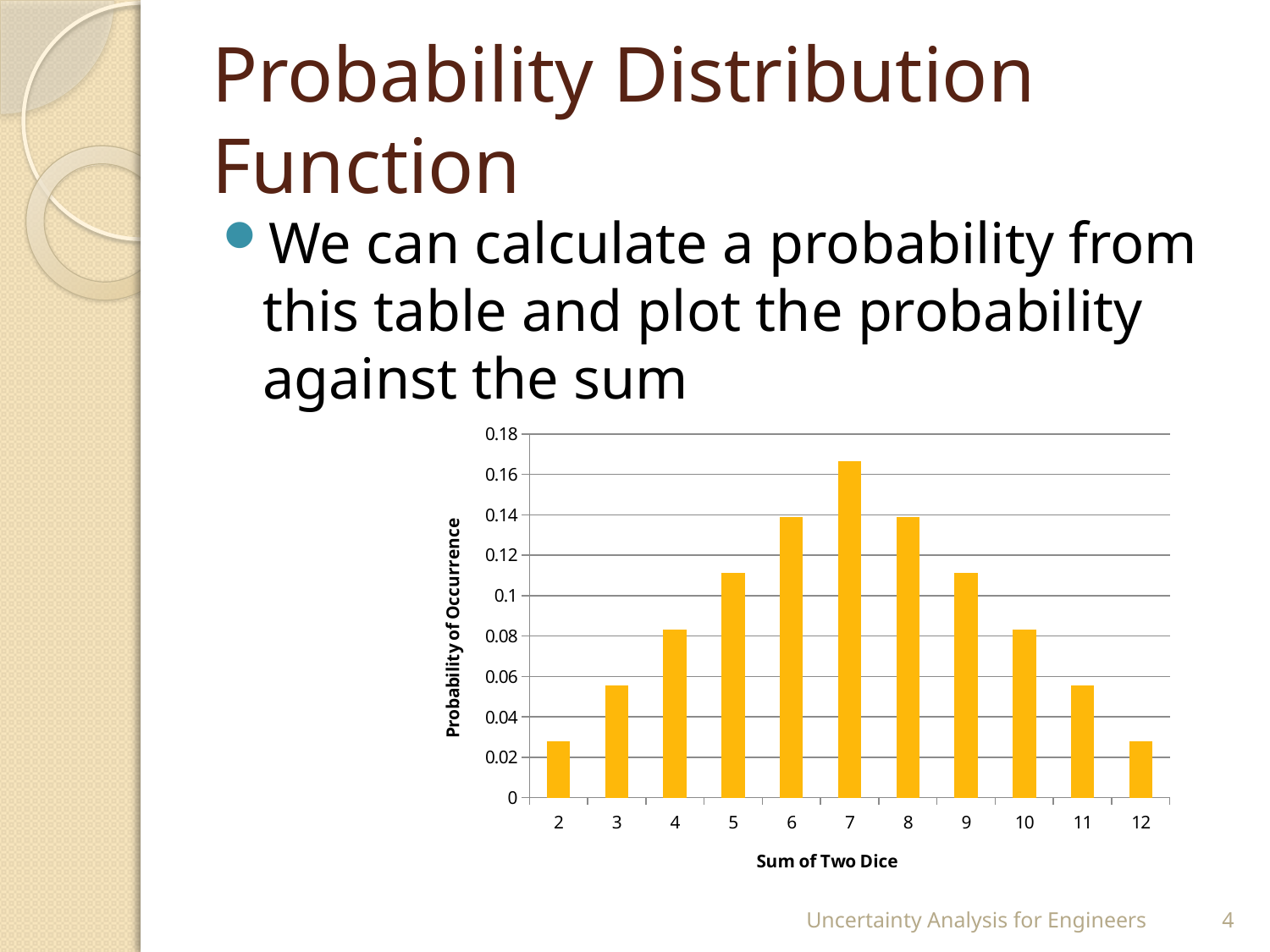
Is the probability of occurrence for a sum of 2 greater or less than 0.04? less What kind of chart is shown on the slide? bar chart Is the probability of occurrence for a sum of 10 greater or less than 0.1? less How do the probabilities change as the sum increases from 2 to 12? They rise up to 7, then fall What is the title of the y axis? Probability of Occurrence Is the probability of occurrence for a sum of 6 greater or less than 0.12? greater Which sum of two dice has the highest probability of occurrence? 7 How many sums (categories) are plotted on the x axis? 11 Which sums of two dice have the lowest probability of occurrence? 2 and 12 Which has a higher probability of occurrence, a sum of 3 or a sum of 8? 8 What is the title of the x axis? Sum of Two Dice